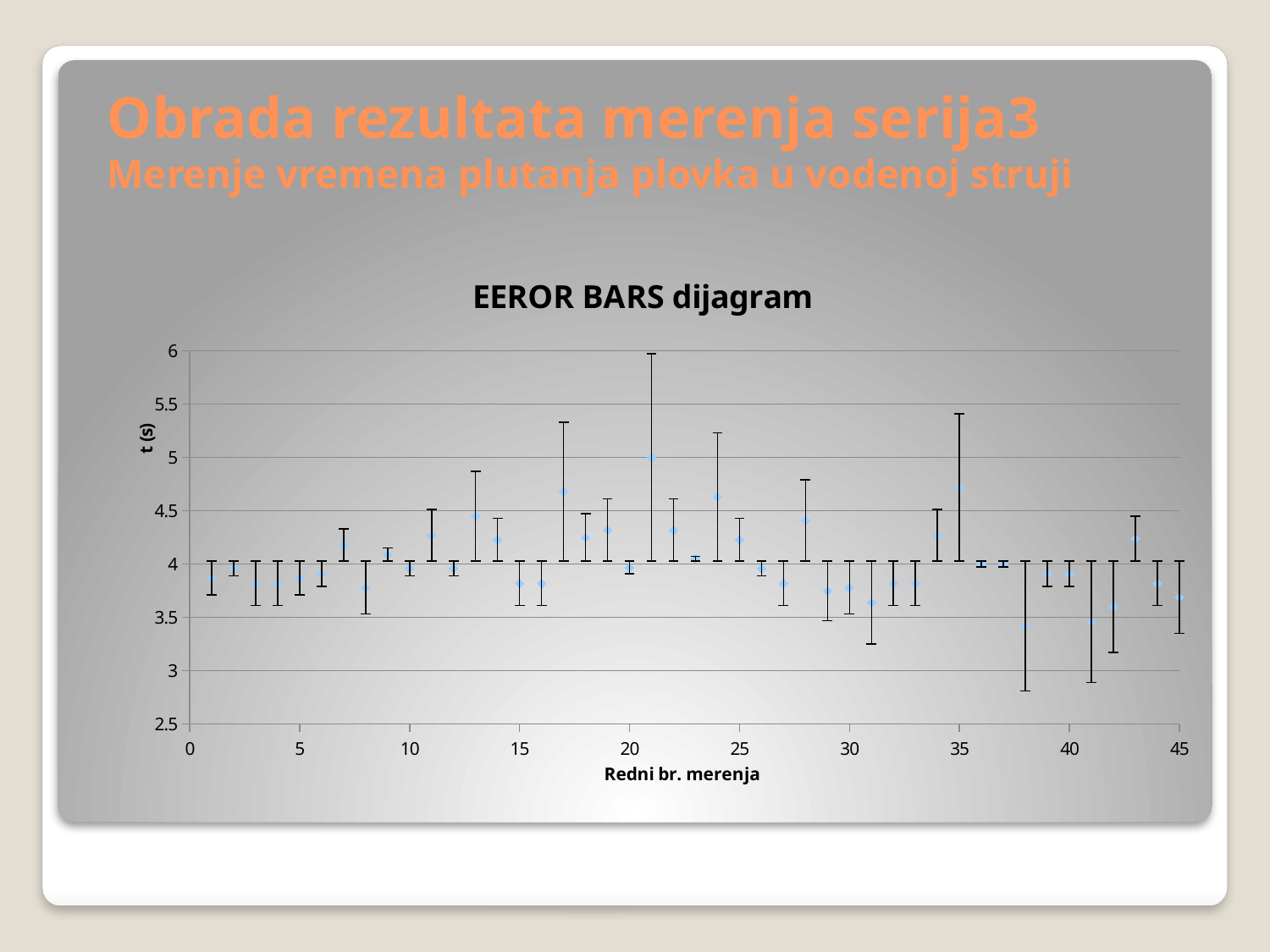
What is the title of the chart? EEROR BARS dijagram Is the value for measurement 31 greater or less than 4? less Which measurement number has the highest value of t (s)? 21 What kind of chart is shown on the slide? scatter chart with error bars Is the value for measurement 3 greater or less than 4? less What is the label of the x axis? Redni br. merenja Which has a larger value of t (s): measurement 13 or measurement 15? measurement 13 Is the value for measurement 21 greater or less than 4.5? greater How many measurement points are plotted on the chart? 45 Which has a larger value of t (s): measurement 21 or measurement 35? measurement 21